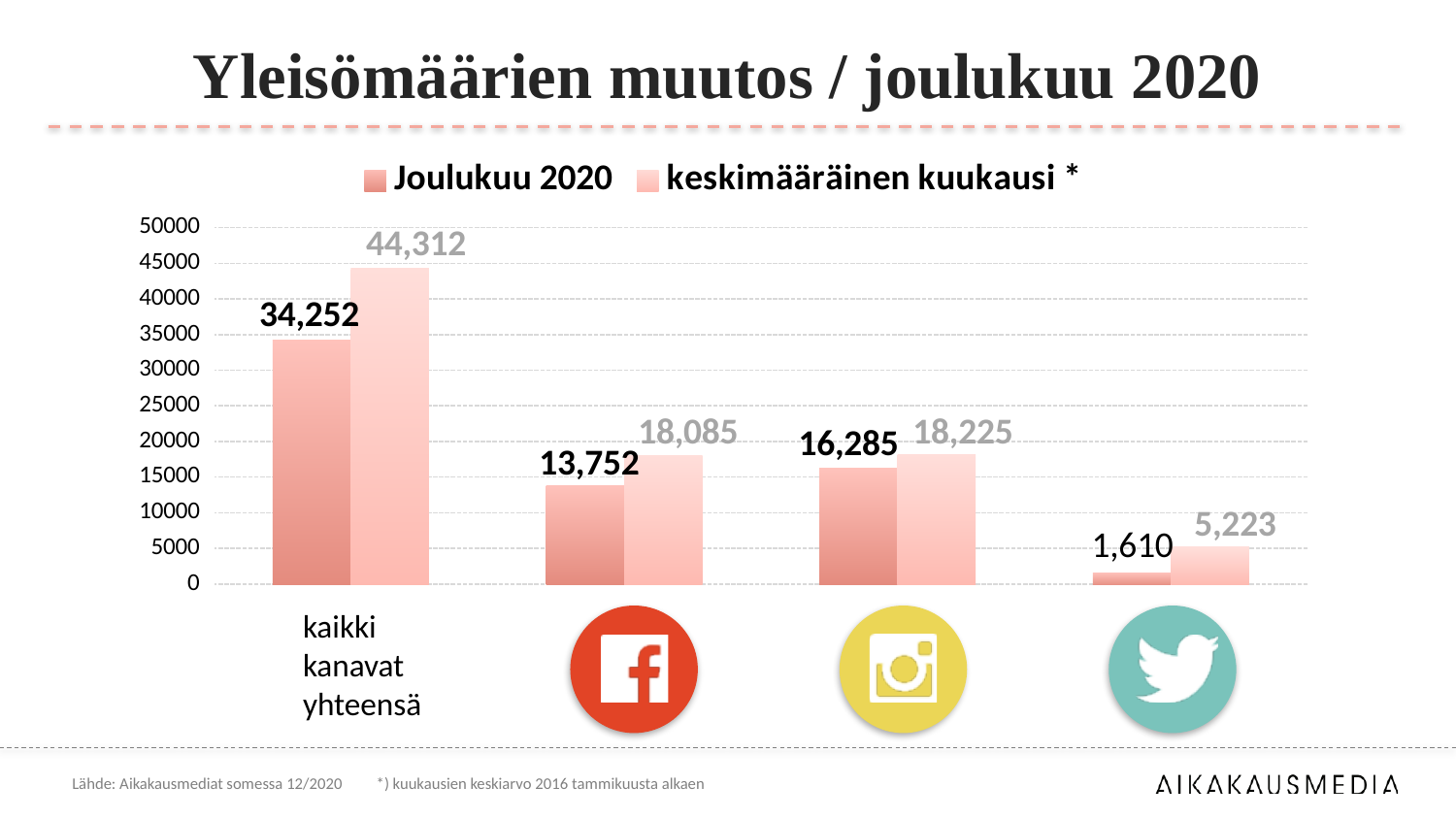
What type of chart is shown on the slide? Bar chart What is the difference between the keskimääräinen kuukausi value and the Joulukuu 2020 value for "kaikki kanavat yhteensä"? 10,060 Which is larger for the Instagram category: the Joulukuu 2020 value or the keskimääräinen kuukausi value? keskimääräinen kuukausi What is the difference between the keskimääräinen kuukausi value and the Joulukuu 2020 value for the Twitter category? 3,613 What is the Joulukuu 2020 value for the Twitter category? 1,610 How many categories are shown on the x axis? 4 Which category has the lowest Joulukuu 2020 value? Twitter How many series does the legend list? 2 What is the Joulukuu 2020 value for the Facebook category? 13,752 What is the value for "kaikki kanavat yhteensä" in the Joulukuu 2020 series? 34,252 What is the value for "kaikki kanavat yhteensä" in the keskimääräinen kuukausi series? 44,312 What is the keskimääräinen kuukausi value for the Instagram category? 18,225